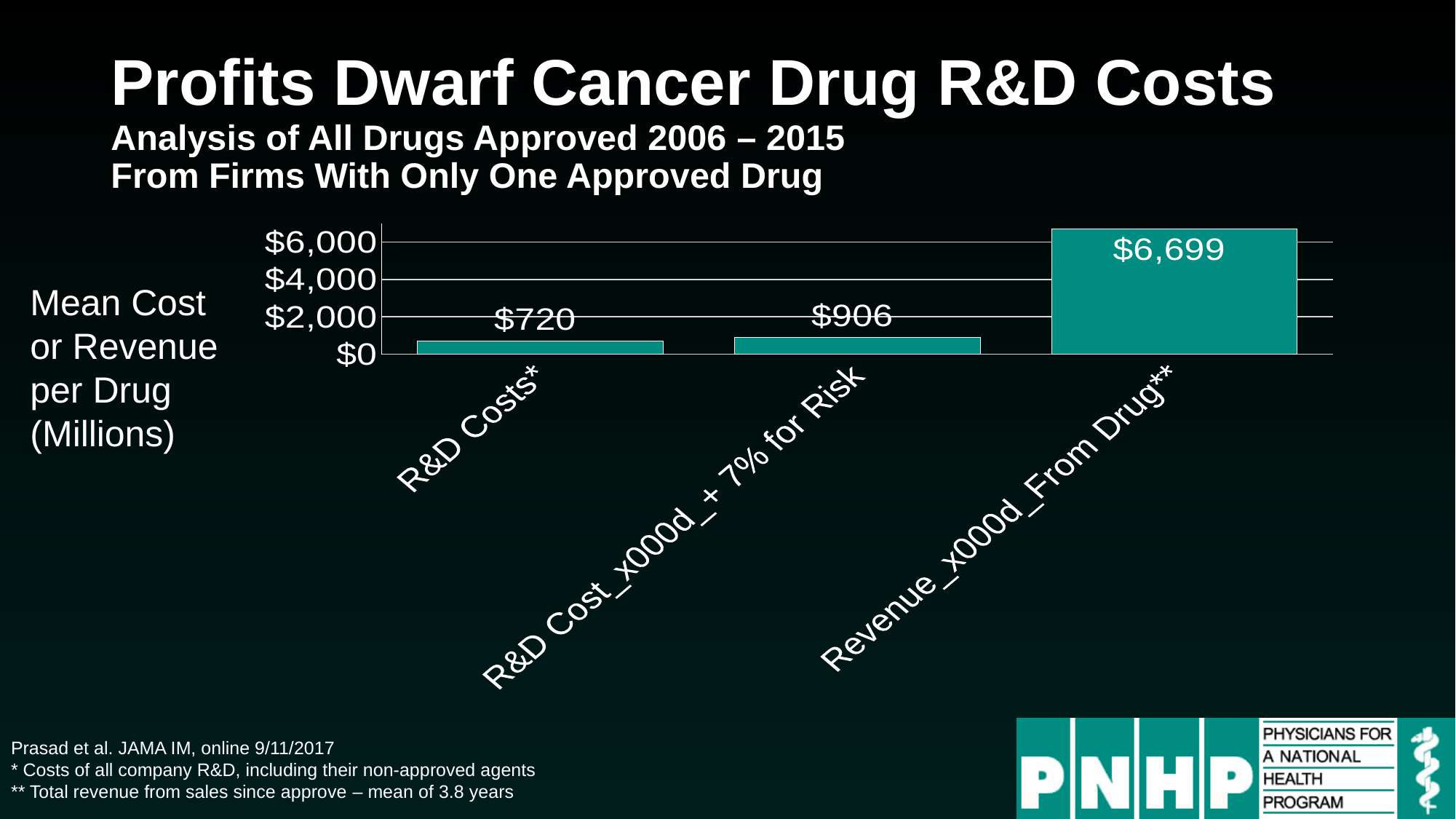
Is the value for Revenue From Drug** greater or less than $6,000? greater What is the value for Revenue From Drug**? $6,699 Which category has the lowest value? R&D Costs* What is the value for R&D Costs*? $720 What is the difference between R&D Cost + 7% for Risk and R&D Costs*? $186 Which category has the highest value? Revenue From Drug** What is the difference between Revenue From Drug** and R&D Costs*? $5,979 Which is larger, R&D Costs* or R&D Cost + 7% for Risk? R&D Cost + 7% for Risk What is the label on the left side of the chart describing the plotted values? Mean Cost or Revenue per Drug (Millions) What is the value for R&D Cost + 7% for Risk? $906 How many bars are shown in the chart? 3 What kind of chart is shown on the slide? bar chart